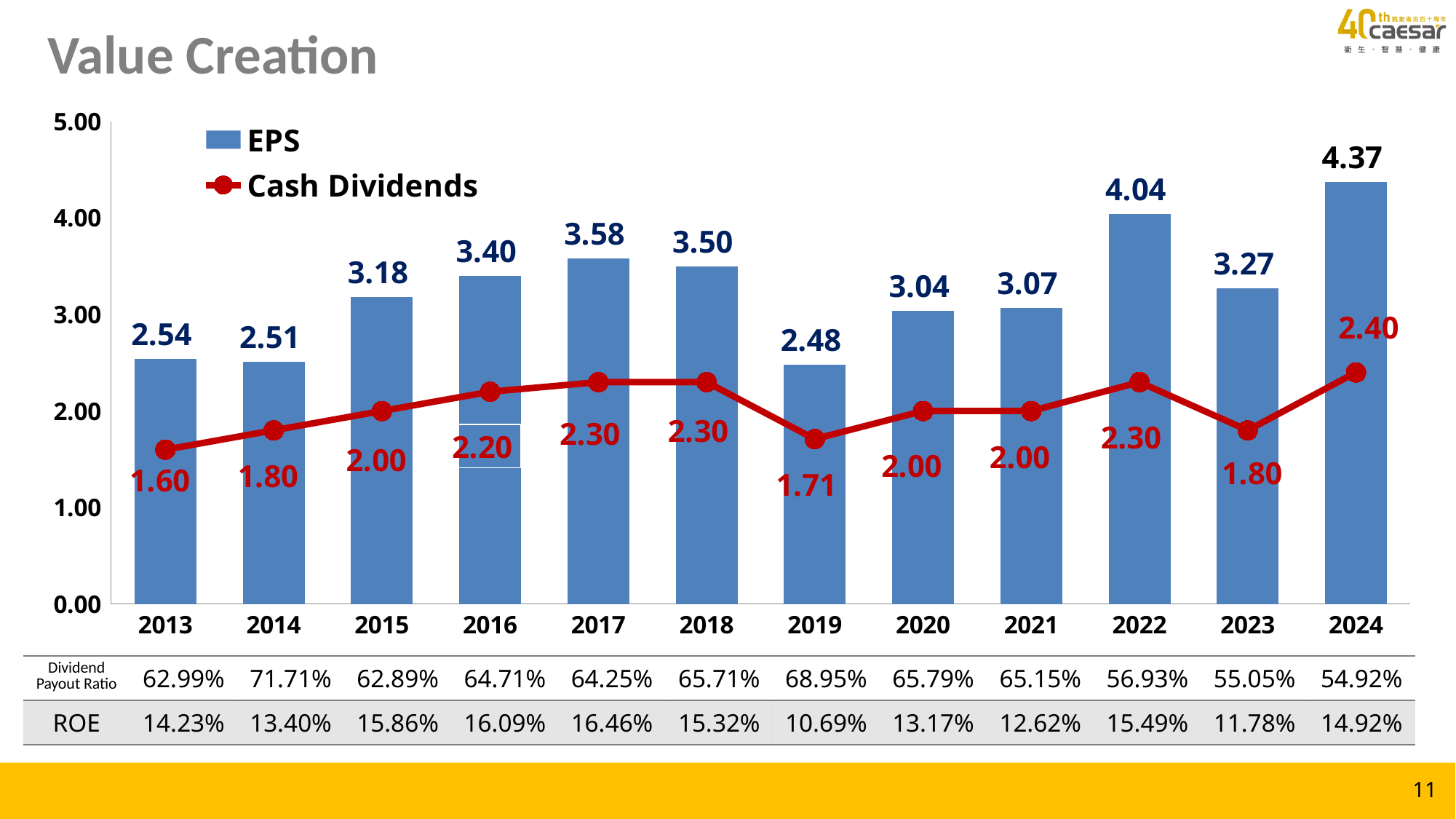
Which year has the highest EPS? 2024 Is the EPS value for 2022 greater or less than 4.00? greater What is the EPS value for 2016? 3.40 What kind of chart is used to show EPS? Bar chart Do the Cash Dividends values rise or fall from 2013 to 2018? Rise What is the Cash Dividends value for 2019? 1.71 What colour is the Cash Dividends line in the chart? Red Which is larger, the EPS for 2017 or the EPS for 2018? 2017 How many series does the chart legend list? 2 What is the difference between the EPS for 2024 and the EPS for 2023? 1.10 How many years are shown on the x axis of the chart? 12 Which year has the lowest Cash Dividends value? 2013